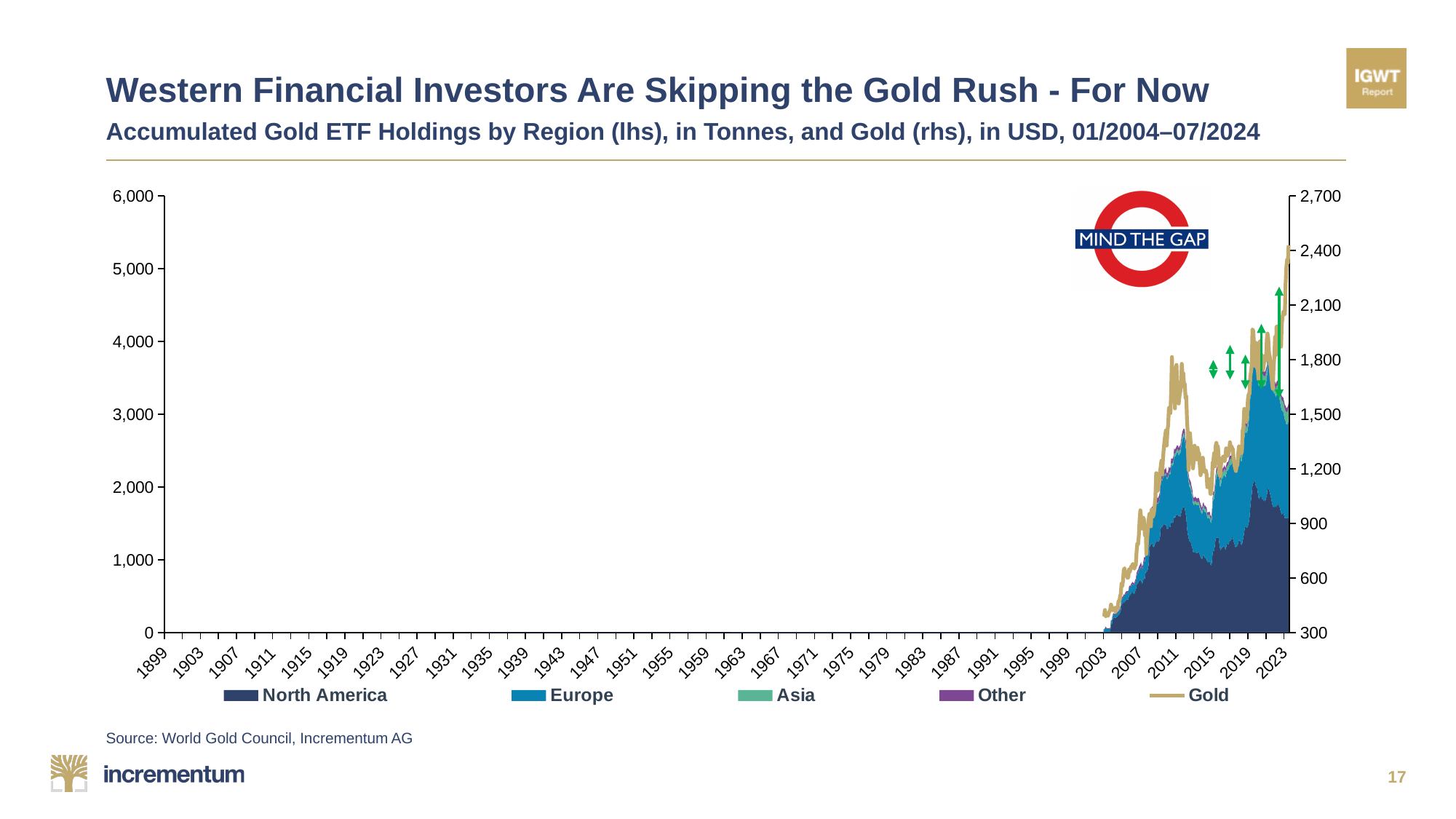
Which series is plotted as a line rather than a filled area? Gold What kind of chart is shown on the slide? A stacked area chart with a line overlay What is the lowest value shown on the right-hand axis? 300 Is the peak of total accumulated gold ETF holdings around 2020 greater or less than 3,000 tonnes? greater In which year do the plotted ETF holdings first appear on the chart? 2004 Is the gold price (right axis) at the end of the series in 2024 greater or less than 2,100 USD? greater Which region holds more gold ETF tonnes, North America or Europe? North America Which region accounts for the largest share of accumulated gold ETF holdings? North America What is the highest value shown on the left-hand axis? 6,000 How many series does the legend list? 5 Do total gold ETF holdings rise or fall between 2020 and 2023? fall Does the gold price rise or fall between 2019 and 2024? rise